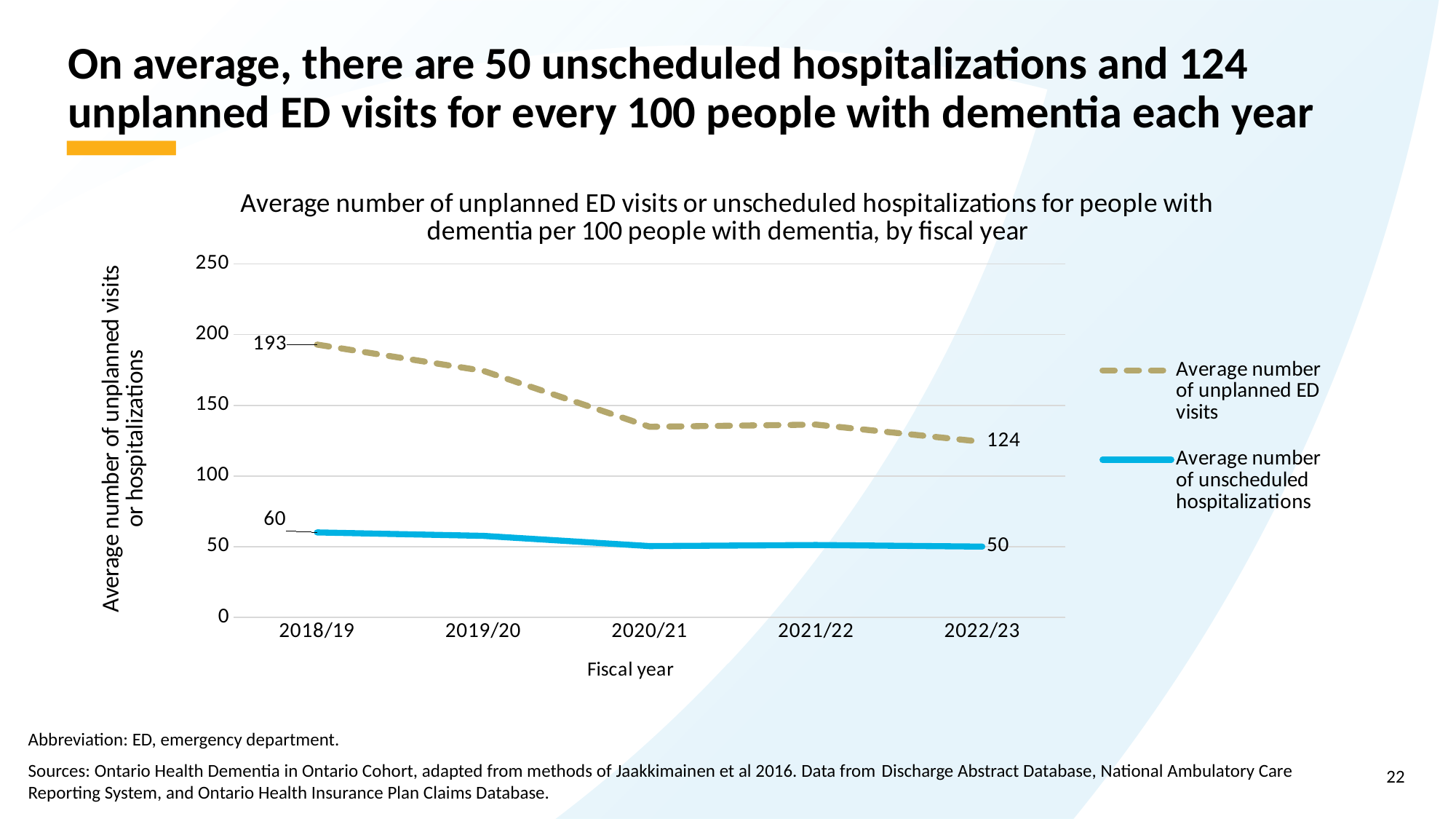
By how much did the average number of unscheduled hospitalizations fall from 2018/19 to 2022/23? 10 By how much did the average number of unplanned ED visits fall from 2018/19 to 2022/23? 69 Is the value for unplanned ED visits in 2019/20 greater or less than 150? greater What is the average number of unplanned ED visits per 100 people with dementia in 2018/19? 193 What is the average number of unscheduled hospitalizations per 100 people with dementia in 2022/23? 50 Which series has the higher value in 2022/23, unplanned ED visits or unscheduled hospitalizations? Average number of unplanned ED visits How many fiscal years are shown on the x axis? 5 What kind of chart is shown on the slide? Line chart What is the average number of unplanned ED visits per 100 people with dementia in 2022/23? 124 Is the value for unplanned ED visits in 2020/21 greater or less than 150? less What is the average number of unscheduled hospitalizations per 100 people with dementia in 2018/19? 60 How many series does the legend list? 2